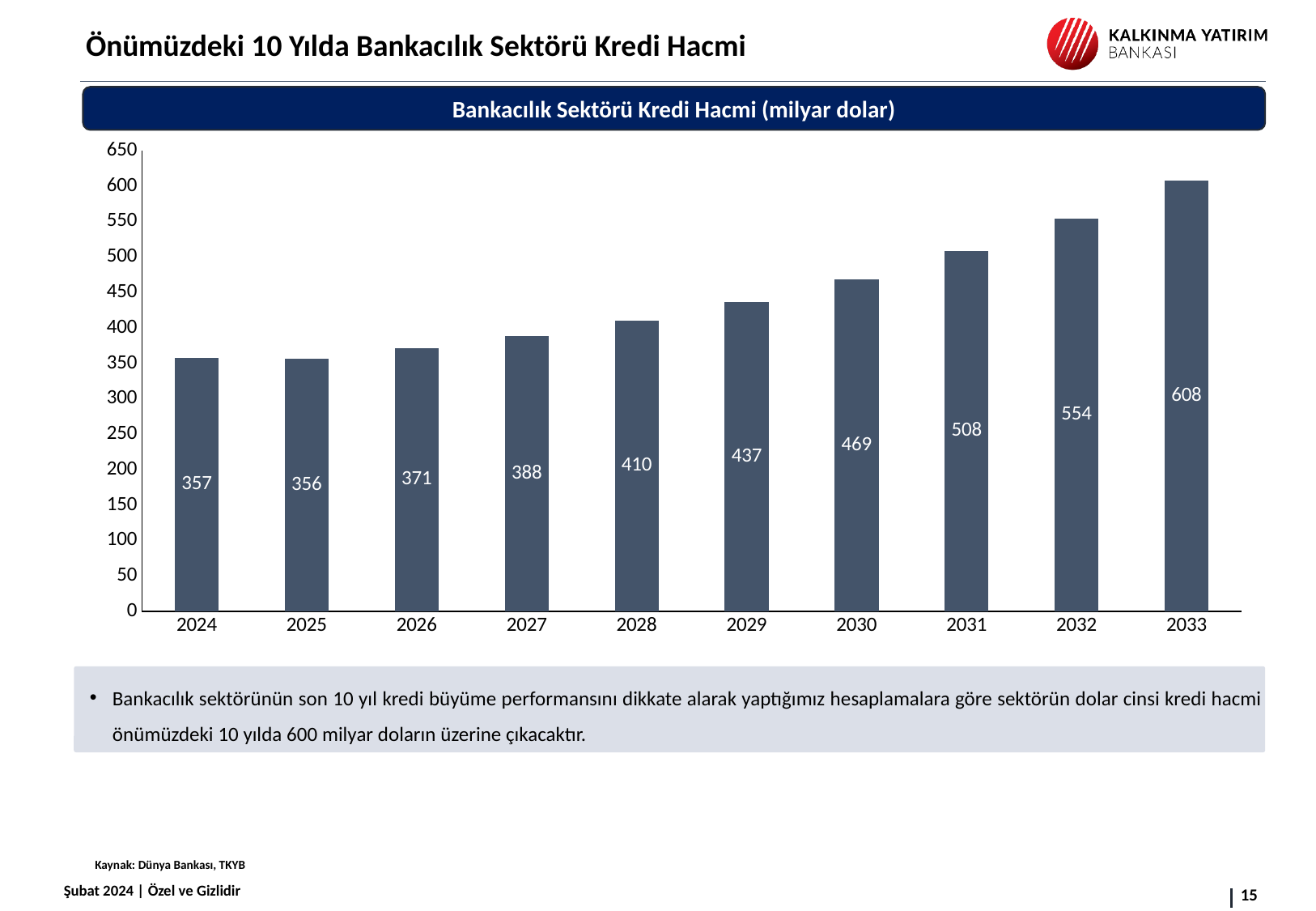
Do the values generally rise or fall from 2025 to 2033? rise Which year has the highest value? 2033 What kind of chart is this? bar chart Is the value for 2031 greater or less than 500? greater How many years are shown on the x axis? 10 Which year has the lowest value? 2025 What is the difference between the values for 2032 and 2031? 46 Which is larger, the value for 2028 or the value for 2030? 2030 What is the difference between the values for 2033 and 2024? 251 What is the value for 2029? 437 What is the value for 2024? 357 What is the value for 2033? 608